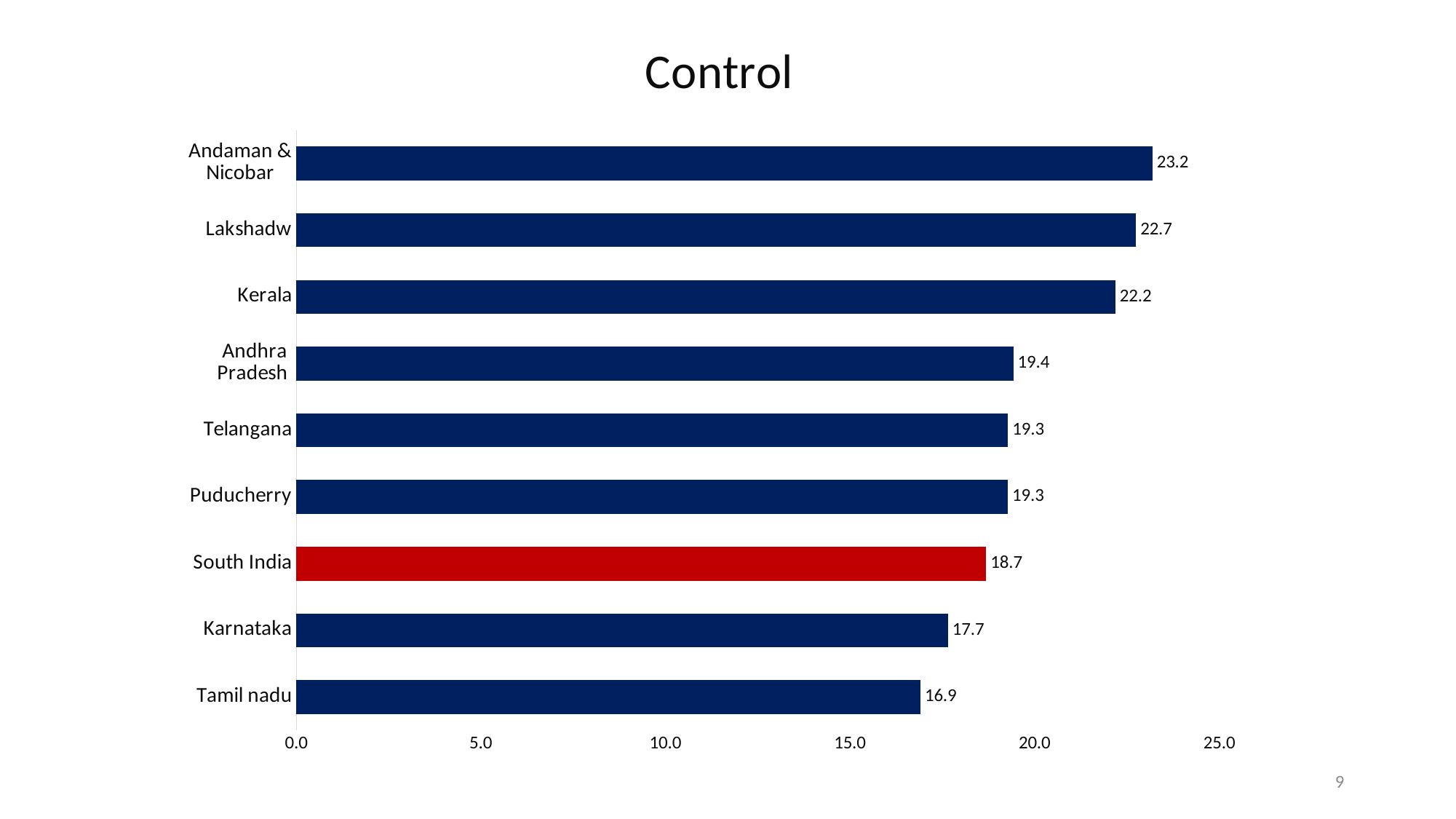
What is the value for Tamil nadu? 16.9 Which category has the lowest value? Tamil nadu Which category has the highest value? Andaman & Nicobar What kind of chart is shown on the slide? bar chart What is the difference between the values for Andaman & Nicobar and Tamil nadu? 6.3 What is the value for Kerala? 22.2 Is the value for Karnataka greater or less than 20.0? less What is the value for South India? 18.7 What is the difference between the values for Kerala and Karnataka? 4.5 How many categories are shown in the chart? 9 What is the title of the chart? Control Which is larger, the value for Lakshadw or the value for Andhra Pradesh? Lakshadw